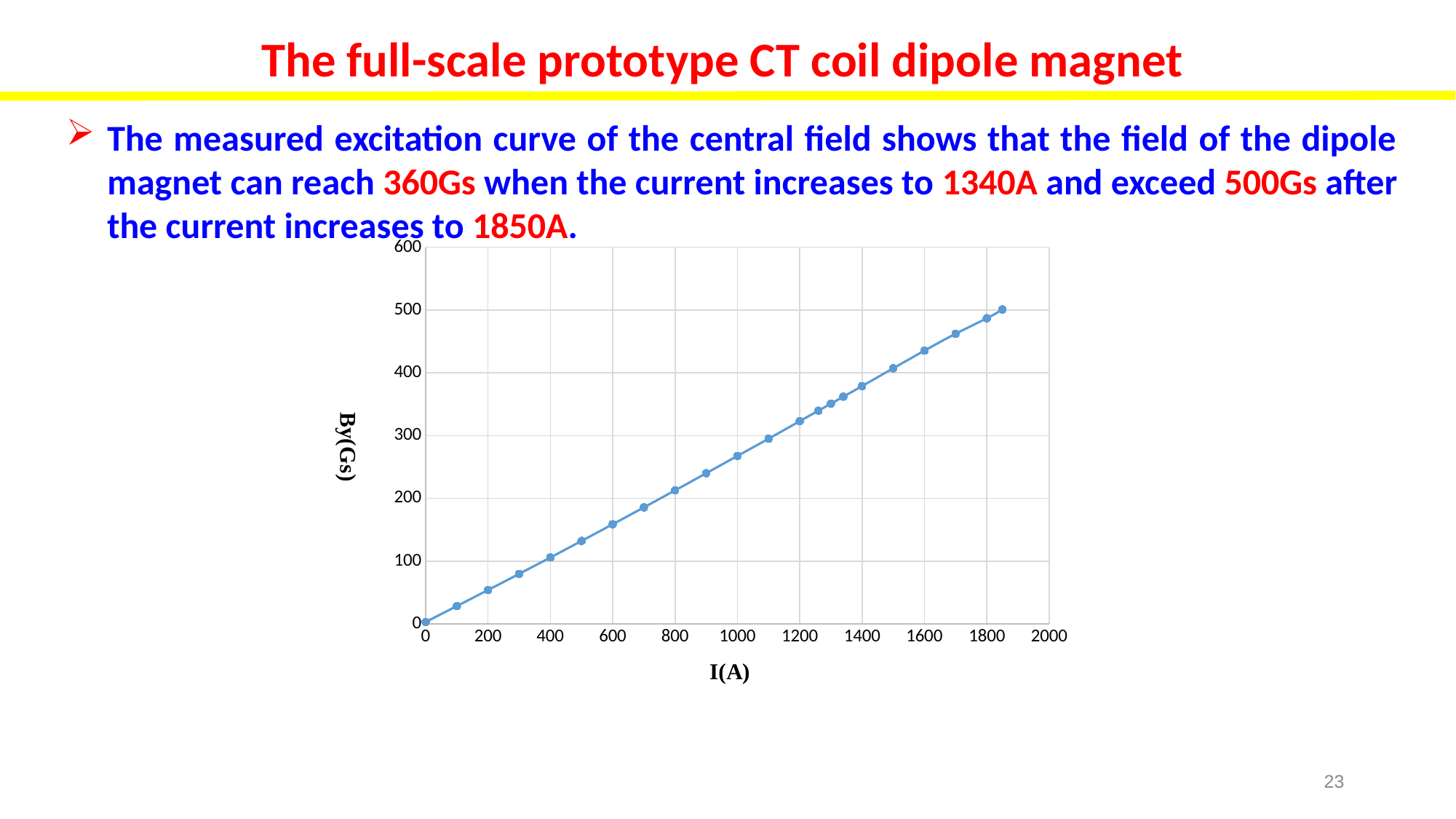
Is the By value at I = 1000 A greater or less than 200? greater At which current value does the plotted By reach its highest point? 1850 What is the label of the x axis of the chart? I(A) Is the By value at I = 600 A greater or less than 100? greater Is the By value at I = 1600 A greater or less than 400? greater At which current value is the plotted By lowest? 0 What kind of chart is shown on the slide? line chart What is the label of the y axis of the chart? By(Gs) Do the plotted By values rise or fall as the current I increases along the x axis? rise Which has the larger By value: the point at I = 800 A or the point at I = 1400 A? 1400 A